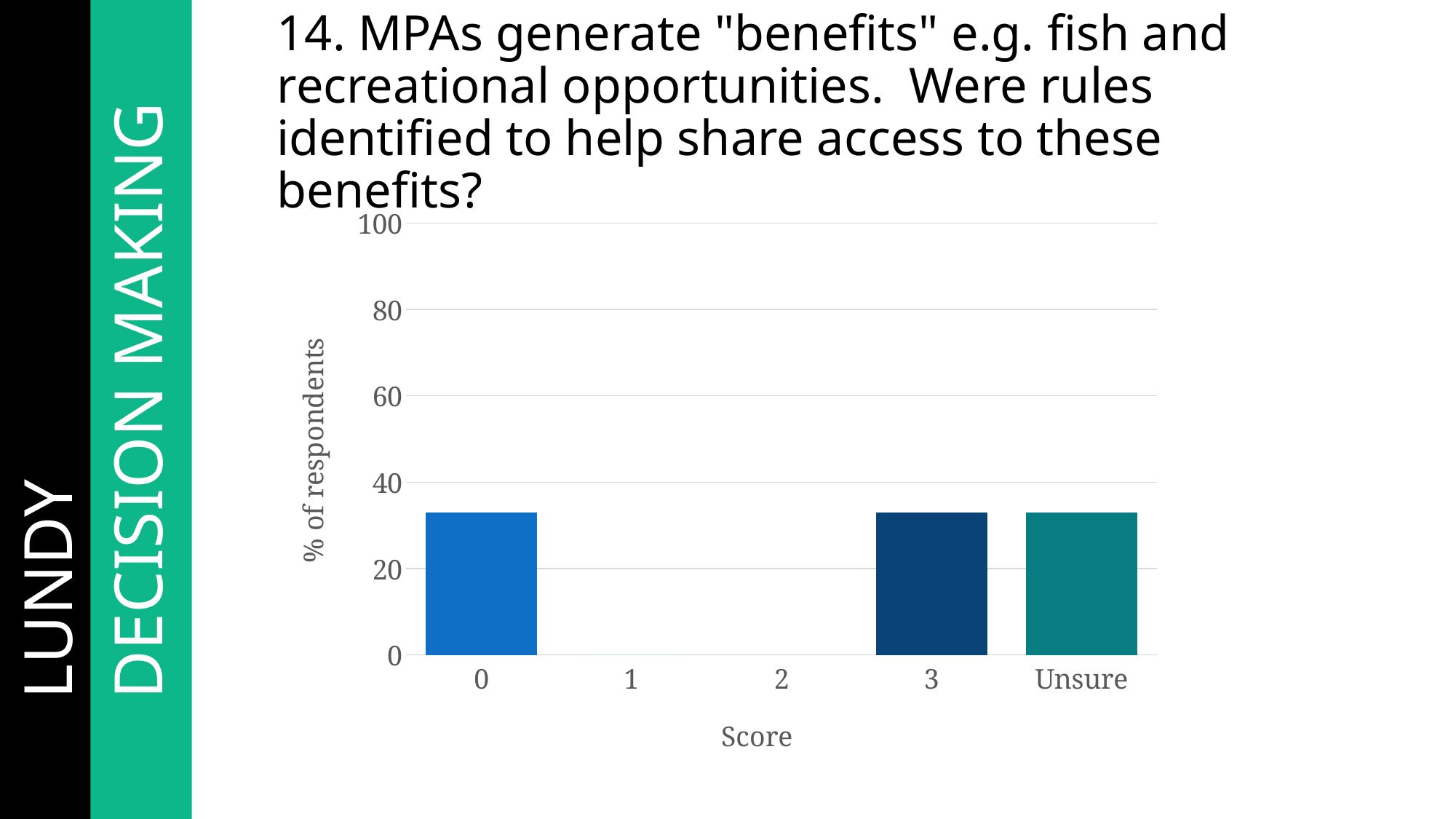
What is the label of the y axis? % of respondents Which has the larger value, score 0 or score 1? 0 Is the value for score 0 greater or less than 40? less Which has the larger value, score 2 or score 3? 3 How many score categories are shown on the x axis? 5 Is the value for Unsure greater or less than 20? greater Is the value for score 0 greater or less than 20? greater What kind of chart is shown on the slide? bar chart Which has the larger value, score 1 or Unsure? Unsure What is the label of the x axis? Score